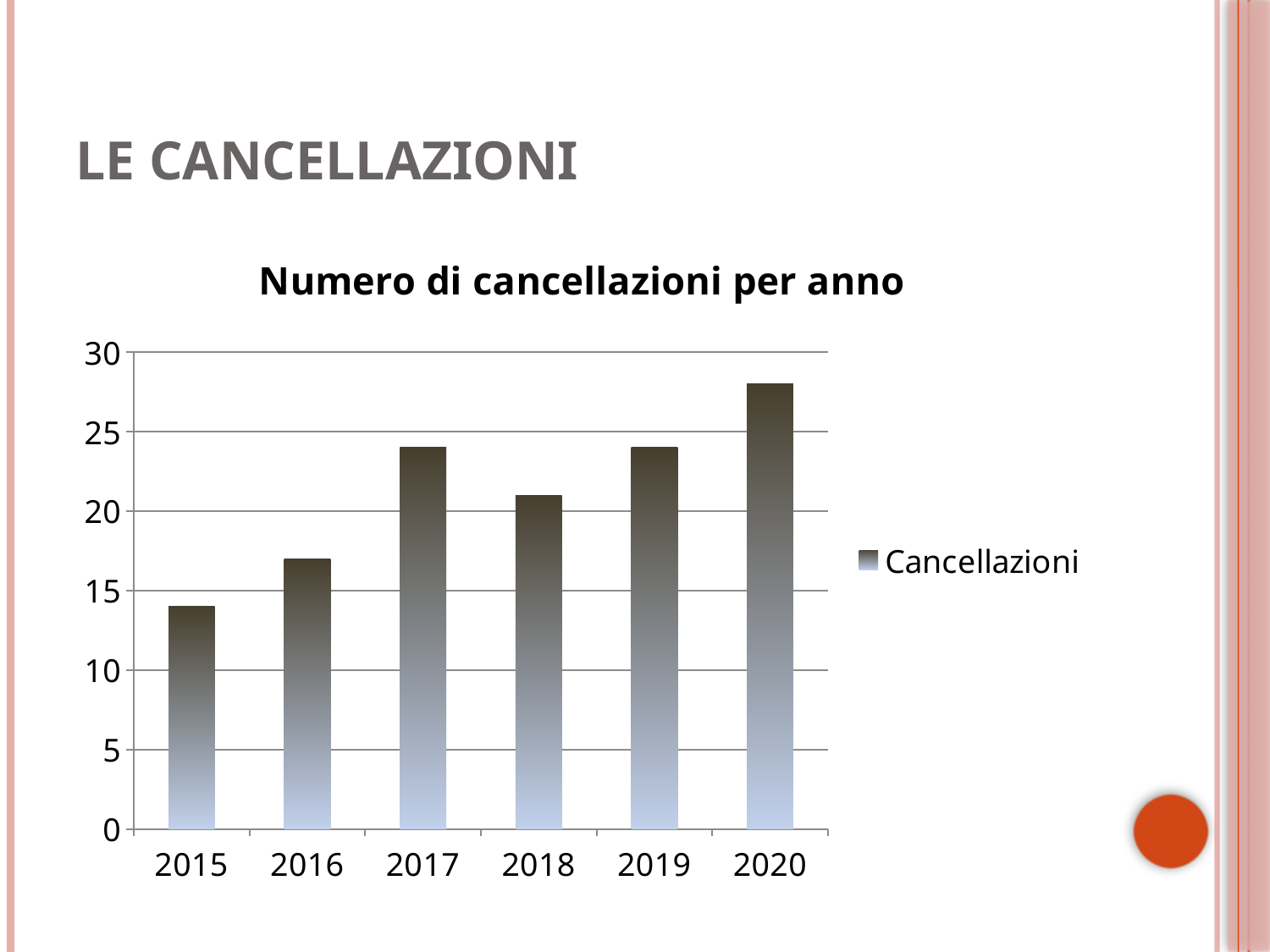
Which year has the lowest number of cancellations? 2015 Which is larger, the value for 2016 or the value for 2018? 2018 What is the name of the series shown in the legend? Cancellazioni Is the value for 2016 greater or less than 15? greater How many series does the legend list? 1 Is the value for 2015 greater or less than 15? less Which year has the highest number of cancellations? 2020 How many years are shown on the x axis? 6 What is the title of the chart? Numero di cancellazioni per anno What kind of chart is shown on the slide? bar chart Is the value for 2020 greater or less than 25? greater